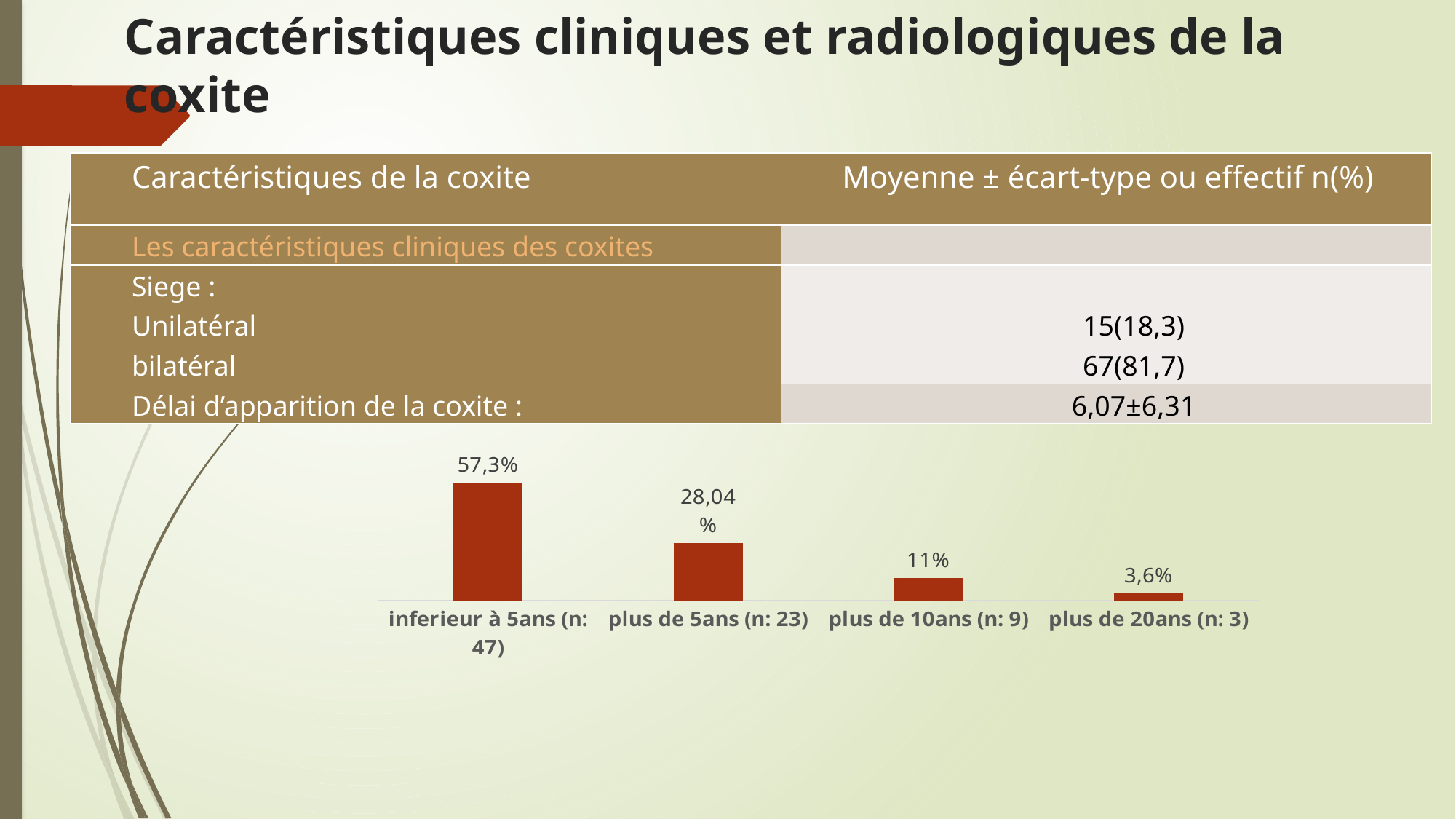
Do the values rise or fall from left to right along the x axis? fall Which is larger, the value for 'plus de 5ans (n: 23)' or the value for 'plus de 10ans (n: 9)'? plus de 5ans (n: 23) What is the difference between the values for 'plus de 10ans (n: 9)' and 'plus de 20ans (n: 3)'? 7,4% Which category has the highest value? inferieur à 5ans (n: 47) What is the value for the category 'inferieur à 5ans (n: 47)'? 57,3% How many categories are shown in the bar chart? 4 Which category has the lowest value? plus de 20ans (n: 3) What is the value for the category 'plus de 5ans (n: 23)'? 28,04% What is the value for the category 'plus de 20ans (n: 3)'? 3,6% What is the difference between the values for 'inferieur à 5ans (n: 47)' and 'plus de 5ans (n: 23)'? 29,26% What is the value for the category 'plus de 10ans (n: 9)'? 11% What kind of chart is shown on the slide? bar chart